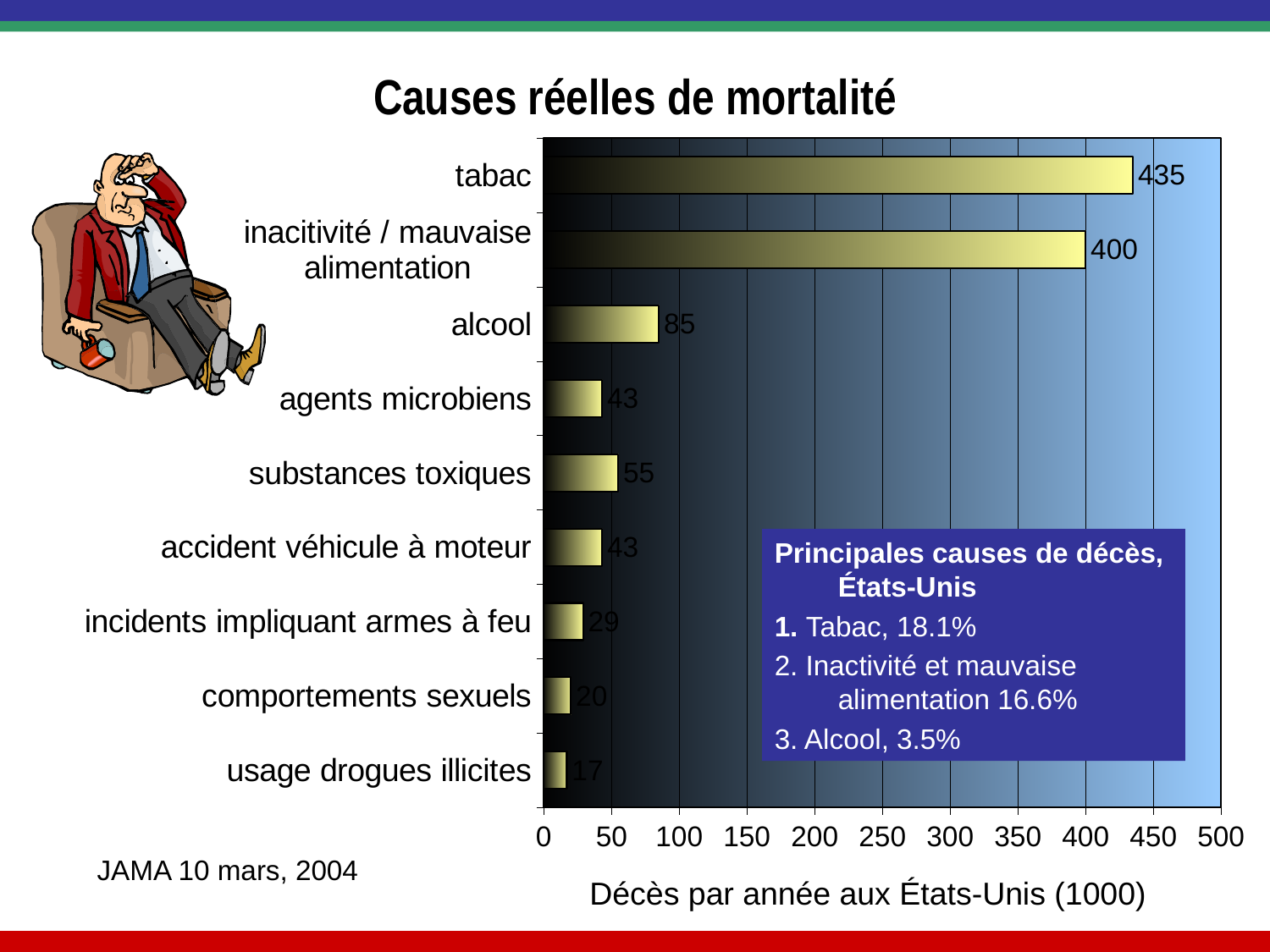
What is the value for alcool? 85 What is the value for substances toxiques? 55 What is the value for tabac? 435 What is the value for usage drogues illicites? 17 What kind of chart is shown on the slide? bar chart Is the value for inacitivité / mauvaise alimentation greater or less than 300? greater What is the x-axis title of the chart? Décès par année aux États-Unis (1000) Which is larger, the value for alcool or the value for substances toxiques? alcool What is the difference between the values for tabac and inacitivité / mauvaise alimentation? 35 Which category has the lowest value? usage drogues illicites Which category has the highest value? tabac How many categories are shown in the chart? 9